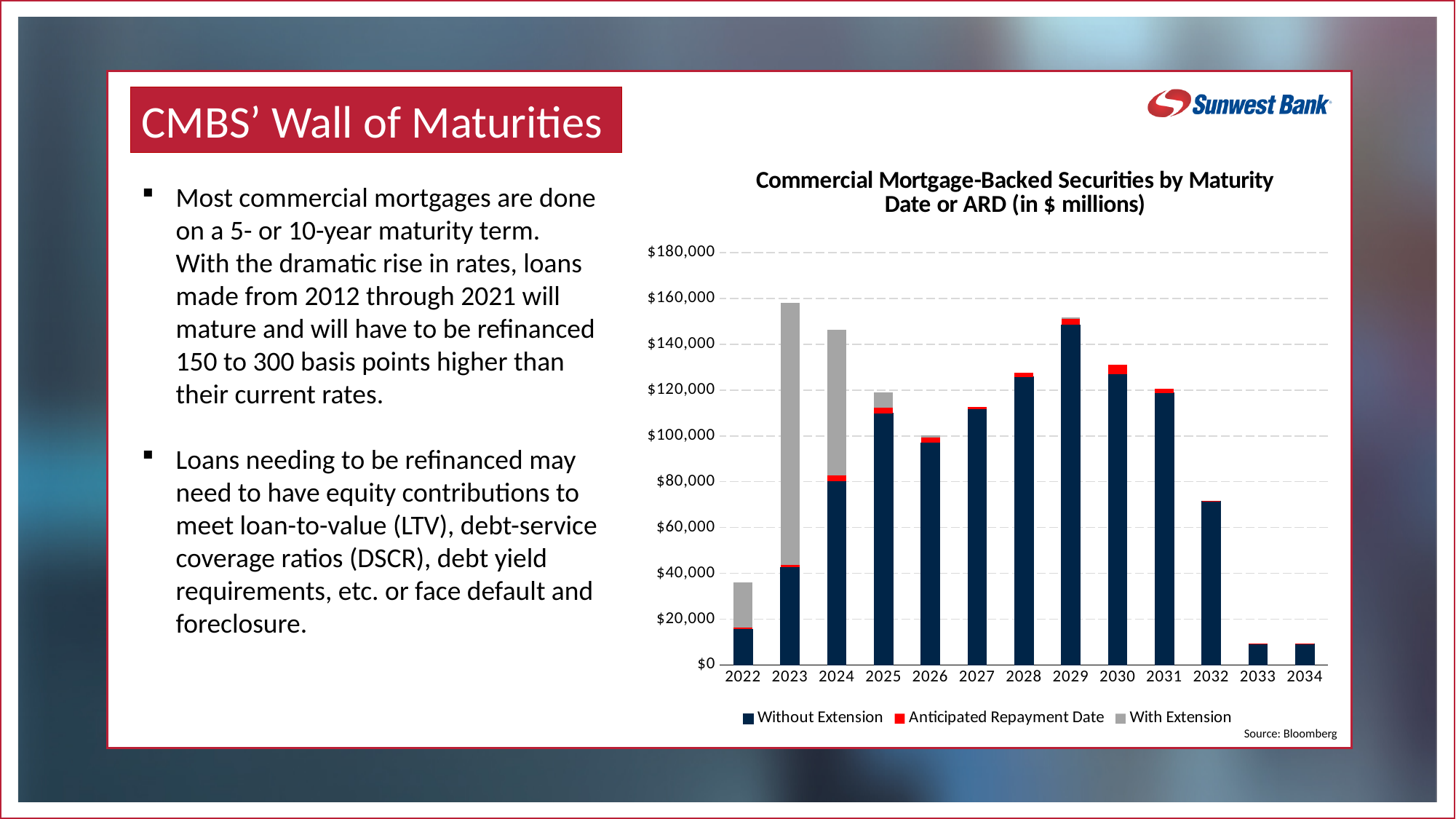
Which year has the tallest Without Extension (dark blue) segment? 2029 Which year has the larger total bar, 2024 or 2025? 2024 Which year has the larger total bar, 2029 or 2032? 2029 Is the total value for 2026 greater or less than $120,000? less Is the total value for 2032 greater or less than $60,000? greater How many years are shown on the x axis? 13 Do the total bar values rise or fall from 2029 to 2034? fall What kind of chart is shown on the slide? Stacked bar chart Is the total value for 2023 greater or less than $140,000? greater How many series does the legend list? 3 Which colour represents the With Extension series in the legend? Gray